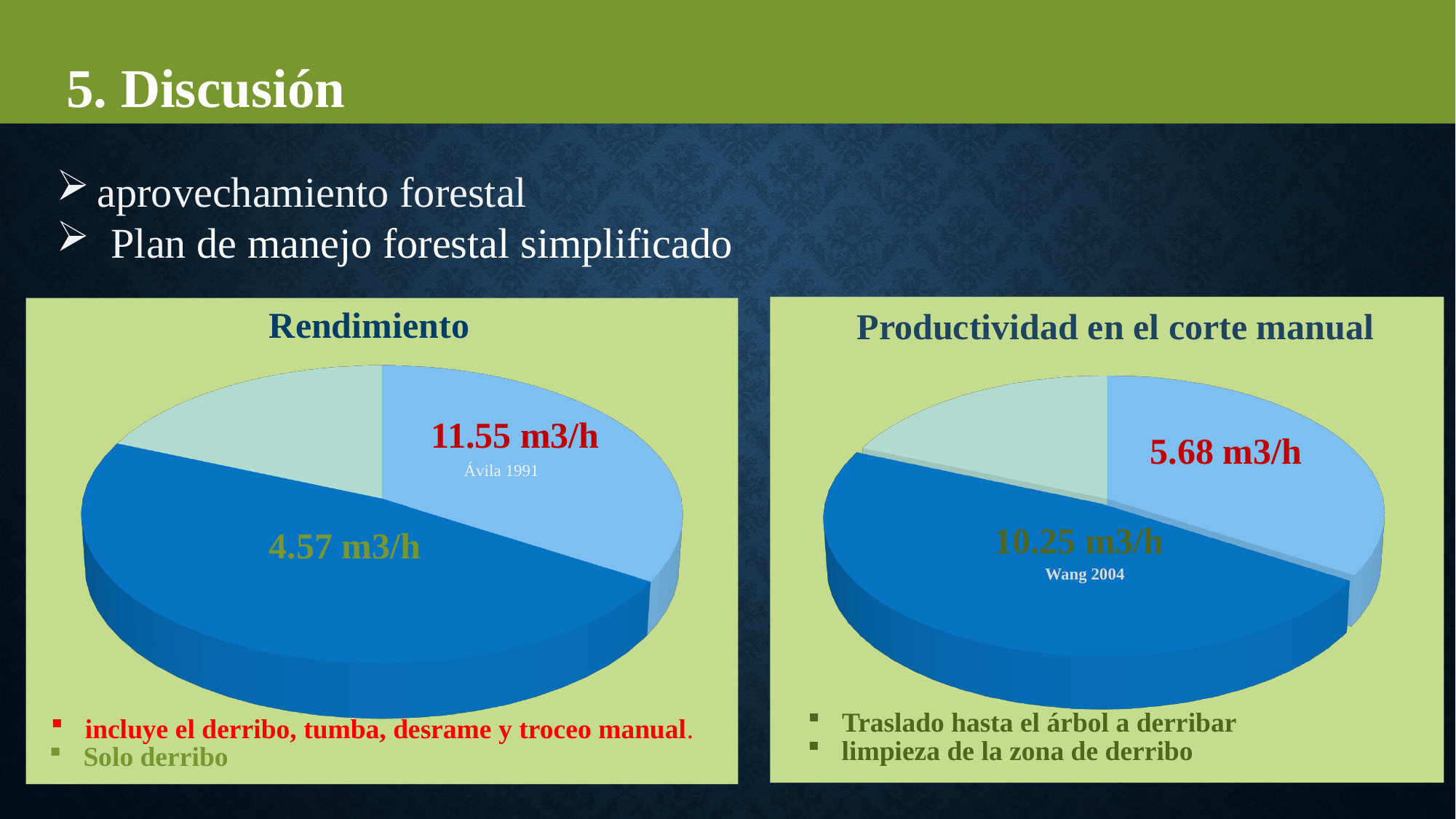
In the "Productividad en el corte manual" chart, what value is attributed to Wang 2004? 10.25 m3/h In the "Productividad en el corte manual" chart, which labelled value is larger, 5.68 m3/h or the Wang 2004 value? The Wang 2004 value (10.25 m3/h) In the "Productividad en el corte manual" chart, what value is labelled on the light blue slice? 5.68 m3/h In the "Rendimiento" chart, which labelled value is larger, the Ávila 1991 value or the 4.57 m3/h value? The Ávila 1991 value (11.55 m3/h) In the "Rendimiento" chart, what value is labelled on the dark blue slice? 4.57 m3/h In the "Rendimiento" chart, what value is labelled on the light blue slice attributed to Ávila 1991? 11.55 m3/h In the "Rendimiento" chart, what is the difference between the two labelled values, 11.55 m3/h and 4.57 m3/h? 6.98 m3/h What is the title of the pie chart on the right side of the slide? Productividad en el corte manual Which source is cited next to the 11.55 m3/h label in the "Rendimiento" chart? Ávila 1991 What kind of chart is shown under the title "Rendimiento"? Pie chart In the "Productividad en el corte manual" chart, what is the difference between the two labelled values, 10.25 m3/h and 5.68 m3/h? 4.57 m3/h What kind of chart is shown under the title "Productividad en el corte manual"? Pie chart